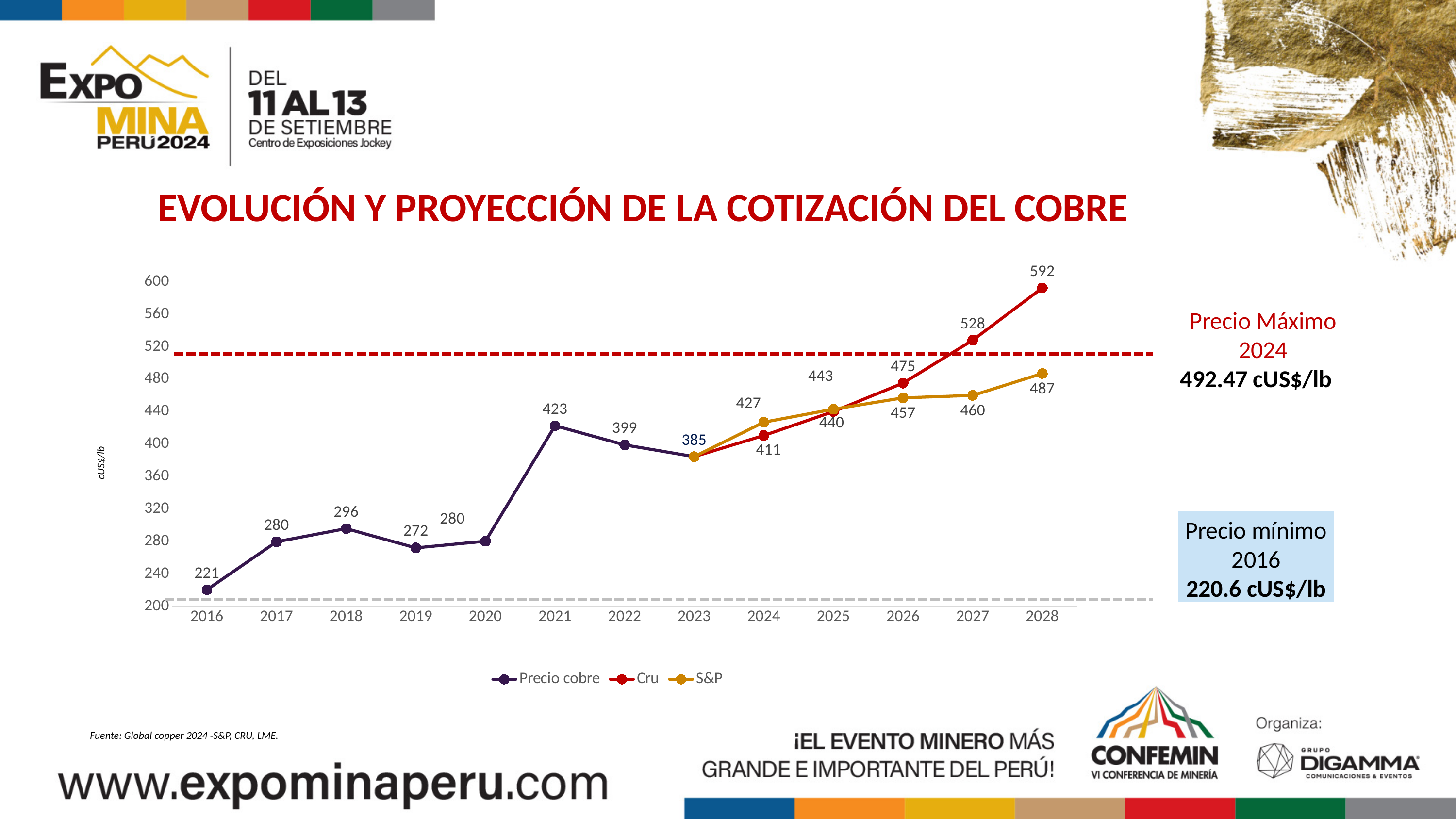
Does the Cru series rise or fall from 2024 to 2028? rise In which year does the Precio cobre series have its lowest value? 2016 What is the Precio Máximo 2024 value noted on the slide? 492.47 cUS$/lb How many years are shown on the x axis? 13 What is the S&P projection for 2028? 487 What kind of chart is shown on the slide? line chart Which series has the higher value in 2027, Cru or S&P? Cru What is the value of Precio cobre in 2016? 221 How many series does the legend list? 3 What is the Cru projection for 2028? 592 In which year does the Precio cobre series reach its highest value? 2021 What is the difference between the Cru and S&P projections for 2028? 105